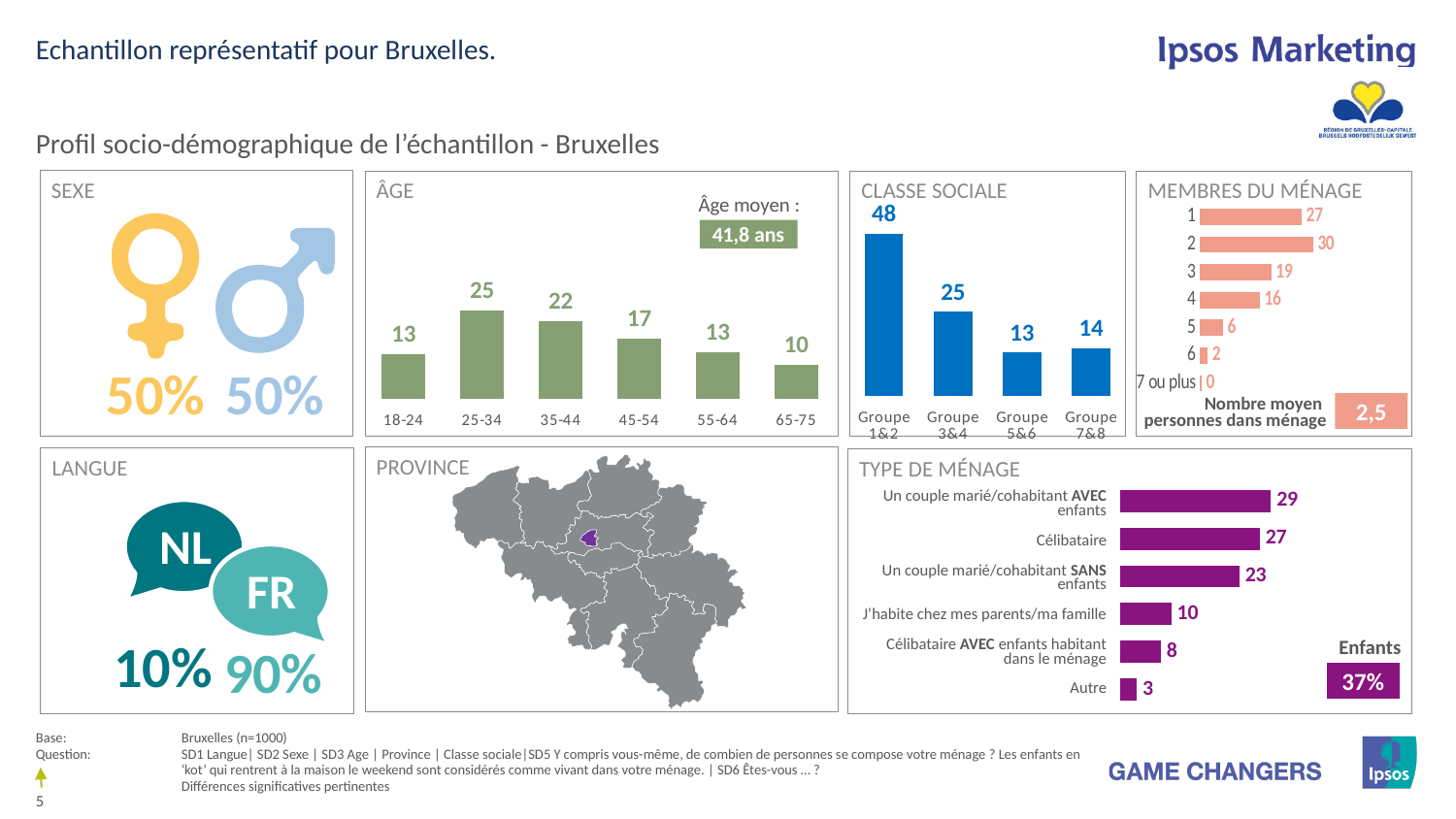
In the TYPE DE MÉNAGE chart, what is the value for Célibataire? 27 In the MEMBRES DU MÉNAGE chart, what is the value for households of 2 members? 30 In the TYPE DE MÉNAGE chart, what is the difference between 'Un couple marié/cohabitant AVEC enfants' and 'Un couple marié/cohabitant SANS enfants'? 6 In the CLASSE SOCIALE chart, what is the value for Groupe 1&2? 48 In the ÂGE chart, which age group has the lowest value? 65-75 What kind of chart is the CLASSE SOCIALE chart? Bar chart In the MEMBRES DU MÉNAGE chart, which household size has the highest value? 2 In the CLASSE SOCIALE chart, which is larger, Groupe 5&6 or Groupe 7&8? Groupe 7&8 In the CLASSE SOCIALE chart, which group has the highest value? Groupe 1&2 In the ÂGE chart, what is the value for the 25-34 age group? 25 In the ÂGE chart, what is the difference between the values for 25-34 and 18-24? 12 In the ÂGE chart, how many age groups are shown? 6